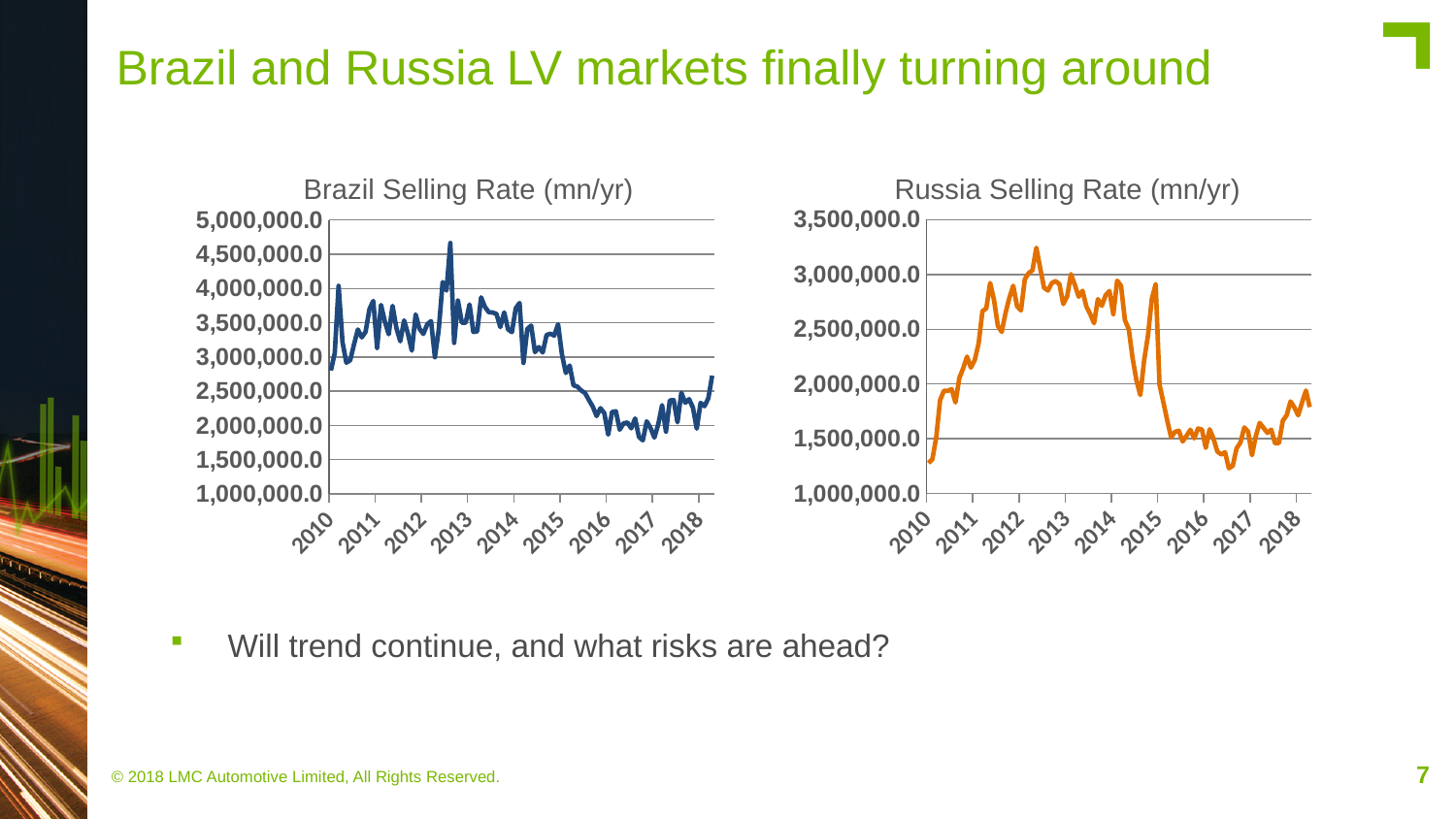
On the Russia Selling Rate (mn/yr) chart, is the peak value reached around 2012 greater or less than 3,000,000.0? greater On the Brazil Selling Rate (mn/yr) chart, are the values during 2016 greater or less than 2,500,000.0? less On the Russia Selling Rate (mn/yr) chart, how many year labels are shown on the x axis? 9 What kind of chart is the Russia Selling Rate (mn/yr) chart? line chart On the Russia Selling Rate (mn/yr) chart, does the selling rate rise or fall between 2010 and 2012? rise On the Russia Selling Rate (mn/yr) chart, are the values during 2016 greater or less than 2,000,000.0? less What colour is the line on the Russia Selling Rate (mn/yr) chart? orange On the Brazil Selling Rate (mn/yr) chart, does the selling rate rise or fall between 2015 and 2016? fall What is the highest value shown on the y axis of the Russia Selling Rate (mn/yr) chart? 3,500,000.0 On the Brazil Selling Rate (mn/yr) chart, how many year labels are shown on the x axis? 9 What kind of chart is the Brazil Selling Rate (mn/yr) chart? line chart